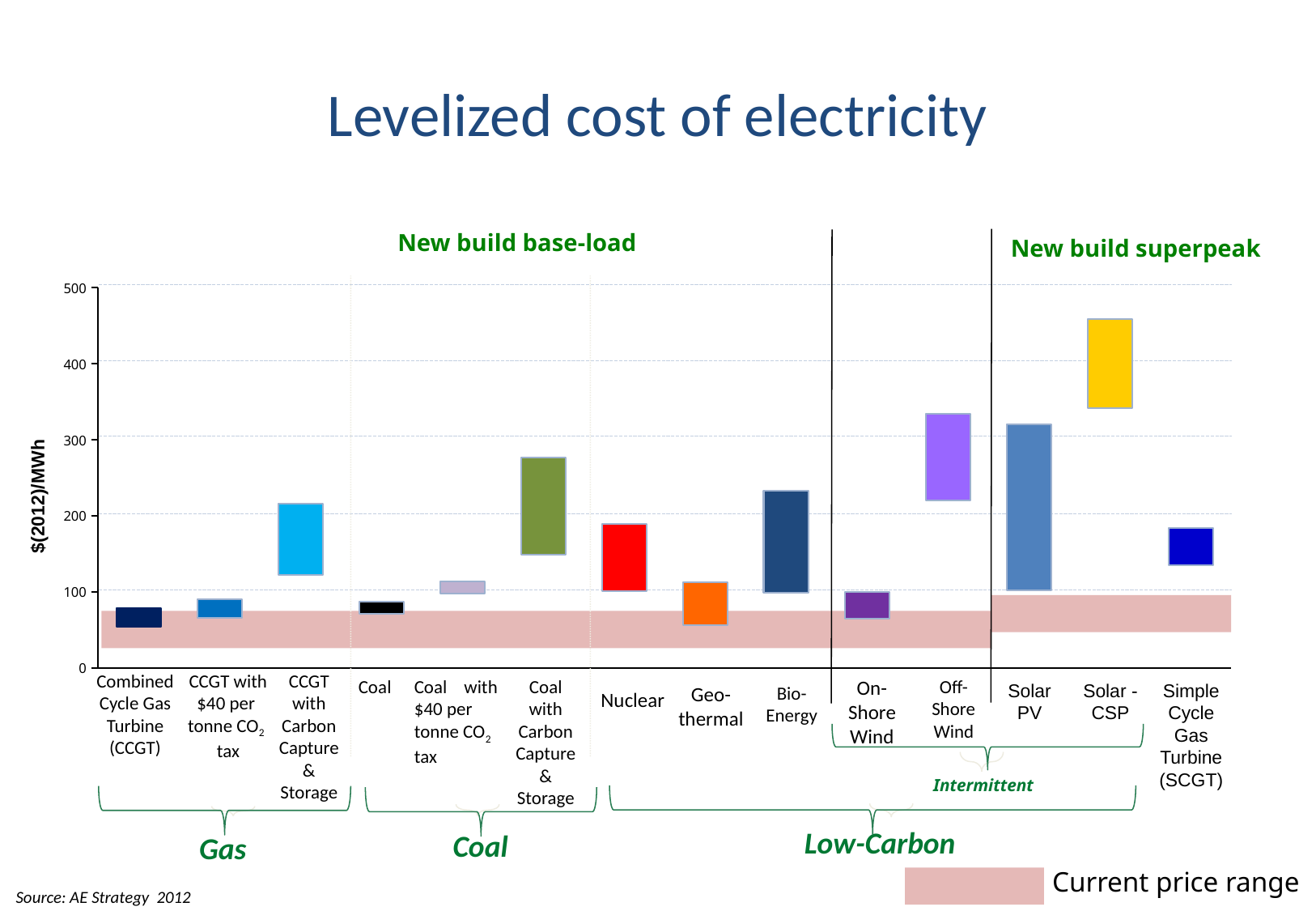
What is the title of the chart? Levelized cost of electricity Which reaches a higher upper cost, Solar - CSP or Solar PV? Solar - CSP What kind of chart is shown on the slide? bar chart What unit is shown on the y axis of the chart? $(2012)/MWh Is the upper end of the cost range for Coal with Carbon Capture & Storage greater or less than 300? less Is the upper end of the cost range for Nuclear greater or less than 200? less Which technology has the highest levelized cost range on the chart? Solar - CSP Is the upper end of the cost range for Solar - CSP greater or less than 400? greater How many technology categories are plotted along the x axis? 14 Which has the higher cost range, Off-Shore Wind or On-Shore Wind? Off-Shore Wind